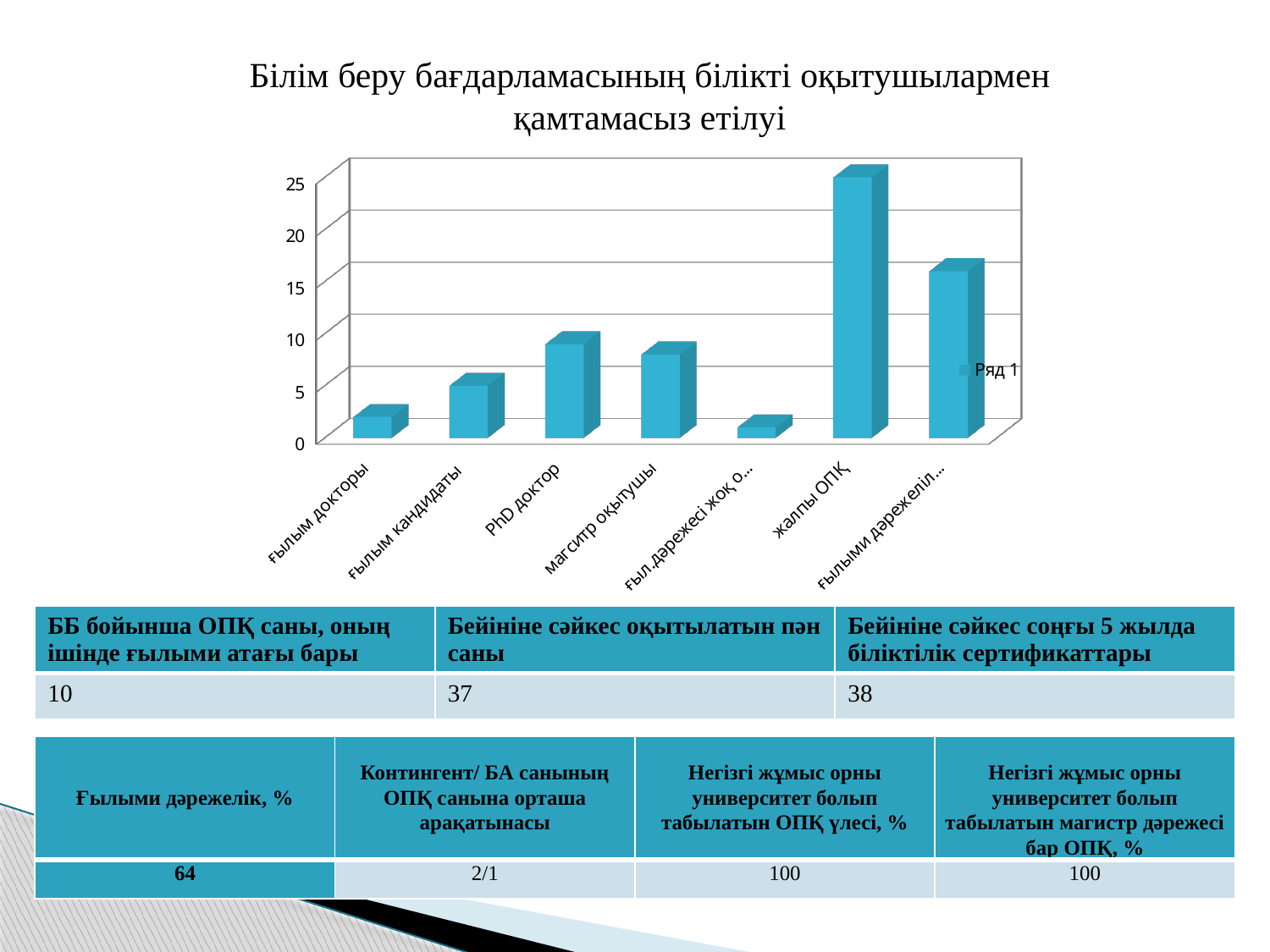
How many series does the chart legend list? 1 Which category has the highest bar in the chart? жалпы ОПҚ How many categories are shown on the x axis of the chart? 7 Is the value for жалпы ОПҚ greater or less than 20? greater Is the value for ғылым докторы greater or less than 5? less Which is larger, the value for PhD доктор or the value for ғылым кандидаты? PhD доктор Is the value for ғылыми дәрежеліл... greater or less than 10? greater Which is larger, the value for жалпы ОПҚ or the value for ғылым докторы? жалпы ОПҚ What kind of chart is shown on the slide? bar chart What is the name of the series shown in the chart legend? Ряд 1 Which category has the lowest bar in the chart? ғыл.дәрежесі жоқ о...